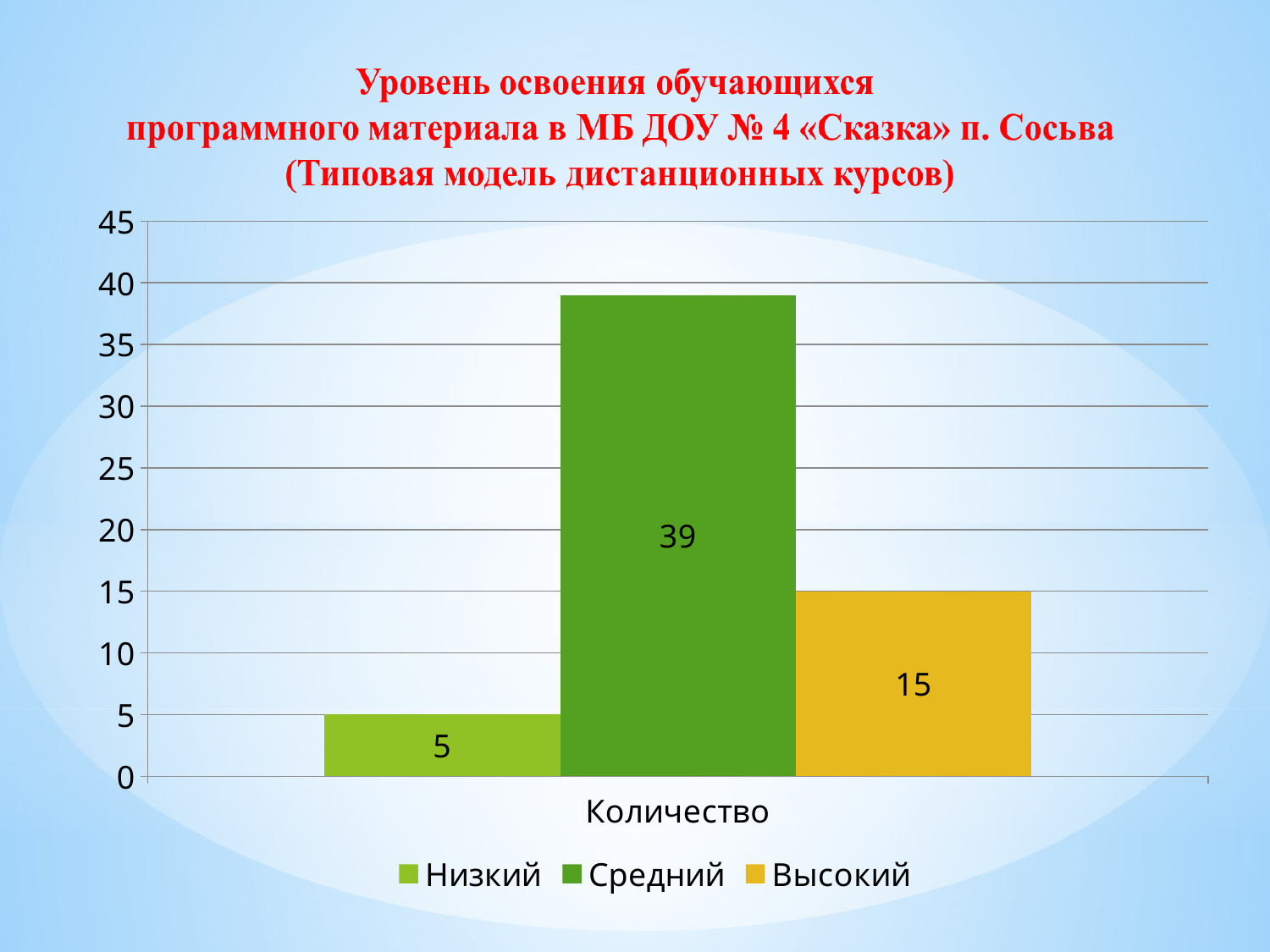
What is the difference between the values for Высокий and Низкий? 10 What is the value for Высокий? 15 Is the value for Средний greater or less than 35? greater Which is larger, the value for Высокий or the value for Низкий? Высокий What is the value for Средний? 39 What is the label on the x axis under the bars? Количество Which series has the highest value? Средний What kind of chart is shown on the slide? bar chart How many series does the legend list? 3 What is the difference between the values for Средний and Высокий? 24 What is the value for Низкий? 5 Which series has the lowest value? Низкий